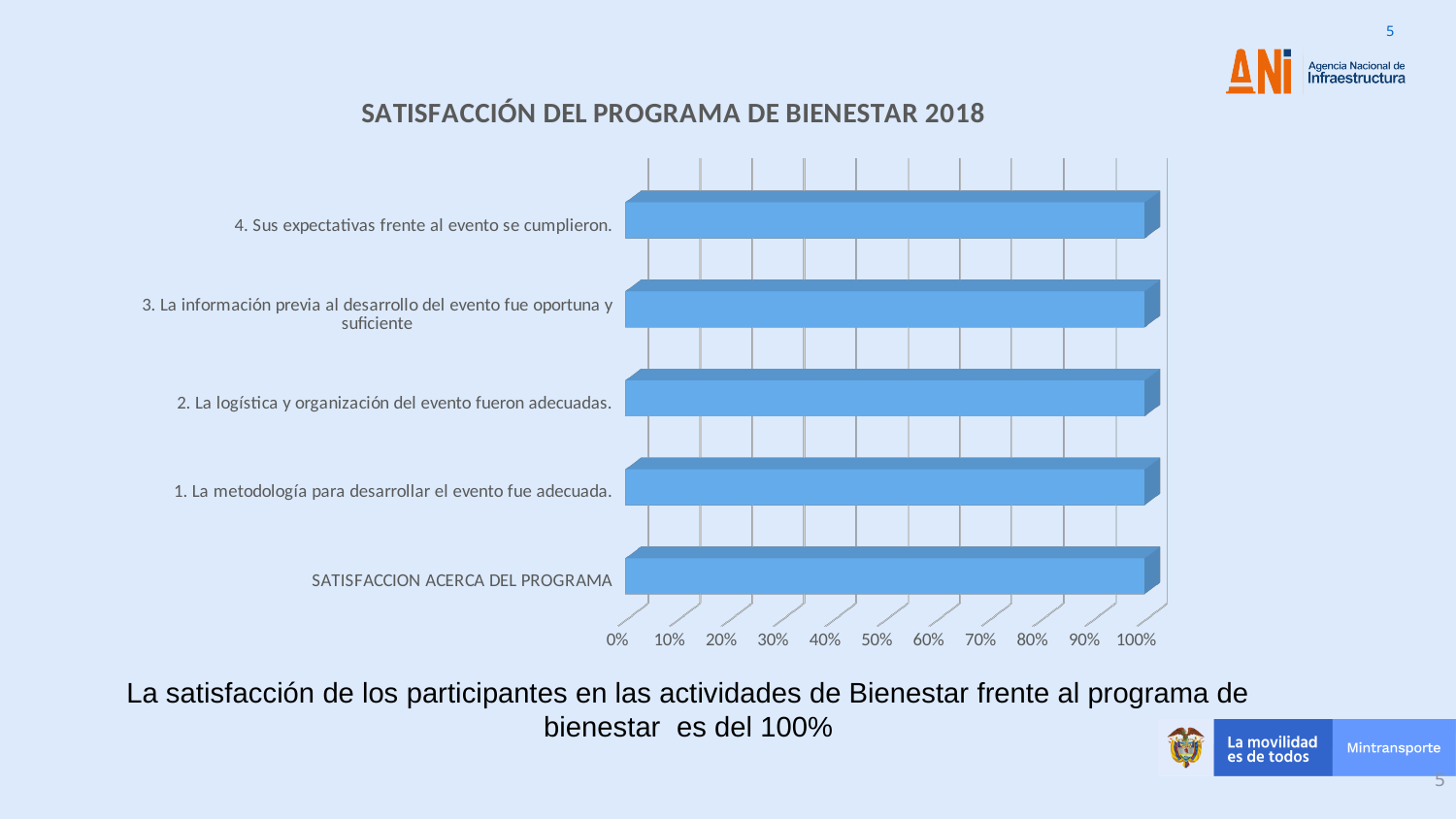
What kind of chart is shown on the slide? bar chart How many categories are plotted in the chart? 5 What is the value for "4. Sus expectativas frente al evento se cumplieron."? 100% Are the bars in the chart oriented horizontally or vertically? horizontally Is the value for "2. La logística y organización del evento fueron adecuadas." greater or less than 90%? greater What is the highest value shown on the x axis of the chart? 100% What is the title of the chart? SATISFACCIÓN DEL PROGRAMA DE BIENESTAR 2018 Is the value for "1. La metodología para desarrollar el evento fue adecuada." greater or less than 50%? greater What is the value for "SATISFACCION ACERCA DEL PROGRAMA"? 100% Is the value for "3. La información previa al desarrollo del evento fue oportuna y suficiente" greater or less than 80%? greater